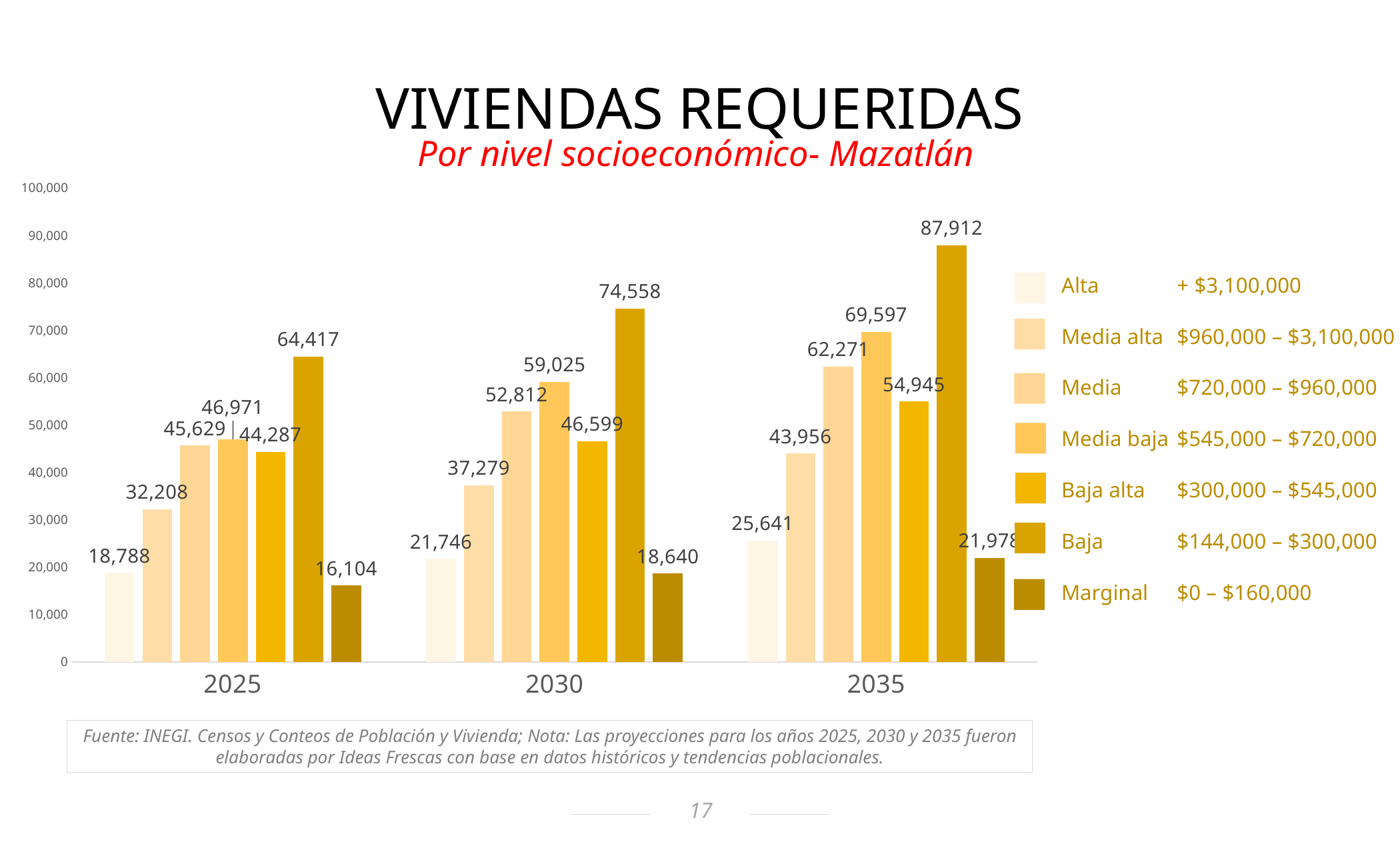
What is the value for Alta in 2025? 18,788 Does the value for Baja rise or fall from 2025 to 2035? rises What is the value for Media baja in 2030? 59,025 Which is larger, Media in 2030 or Baja alta in 2030? Media in 2030 Which socioeconomic level has the lowest value in 2025? Marginal What price range does the legend give for the Media alta level? $960,000 – $3,100,000 What is the difference between the Baja values for 2035 and 2025? 23,495 How many series does the legend list? 7 What kind of chart is shown on the slide? bar chart What is the value for Baja in 2035? 87,912 How many year categories are shown on the x axis? 3 Which socioeconomic level has the highest value in 2030? Baja